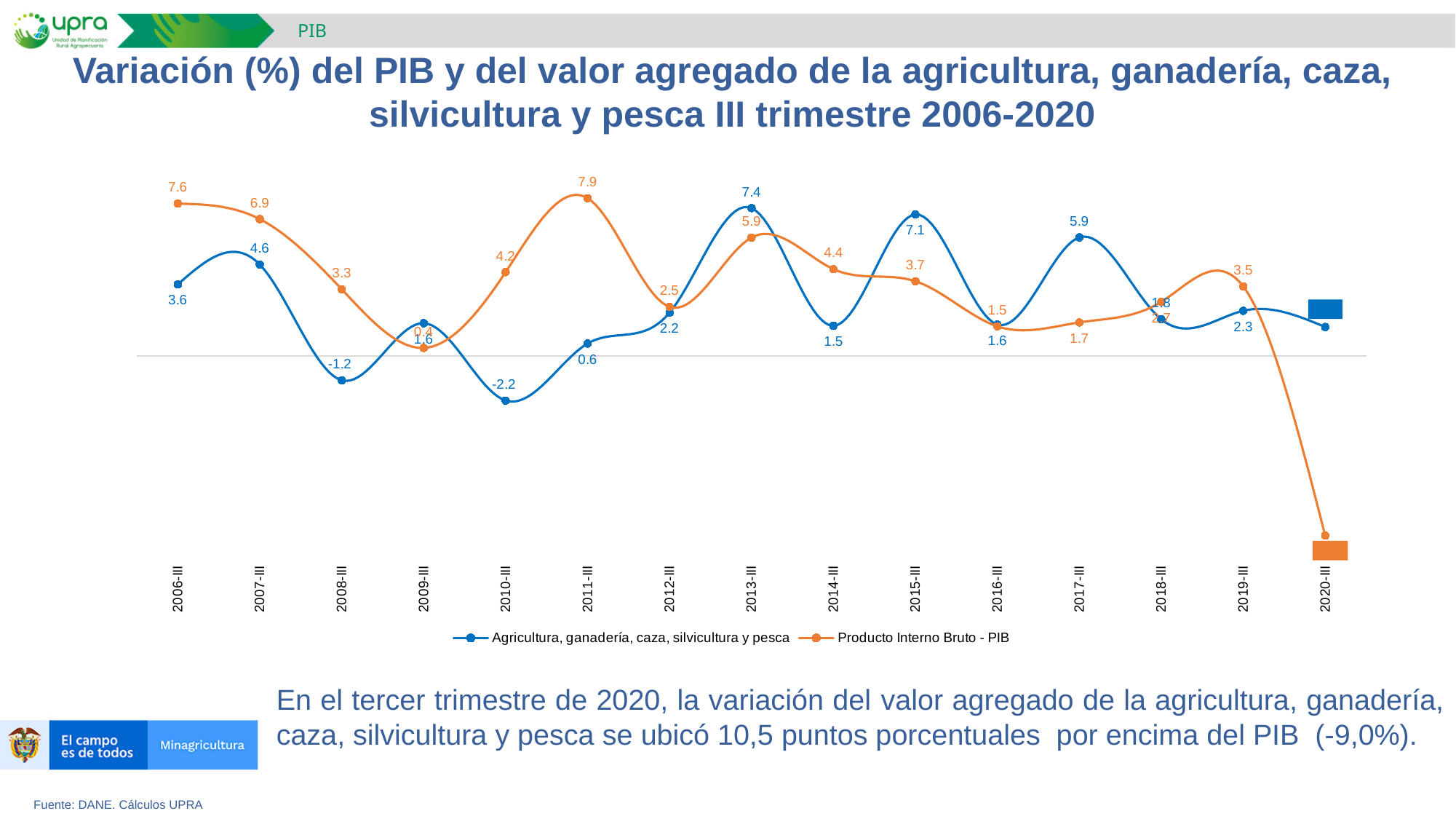
How many quarters (points) are plotted along the x axis? 15 What is the value for Agricultura, ganadería, caza, silvicultura y pesca in 2013-III? 7.4 In 2015-III, which series has the larger value, Agricultura, ganadería, caza, silvicultura y pesca or Producto Interno Bruto - PIB? Agricultura, ganadería, caza, silvicultura y pesca What is the difference between the Agricultura series and the PIB series in 2013-III? 1.5 How many series does the legend list? 2 Is the value for Producto Interno Bruto - PIB in 2020-III greater or less than 0? less What kind of chart is shown on the slide? line chart In which quarter does the Producto Interno Bruto - PIB series reach its highest value? 2011-III What is the value for Agricultura, ganadería, caza, silvicultura y pesca in 2008-III? -1.2 What is the value for Producto Interno Bruto - PIB in 2011-III? 7.9 What colour is the line for Producto Interno Bruto - PIB? orange In which quarter does the Agricultura, ganadería, caza, silvicultura y pesca series reach its lowest value? 2010-III